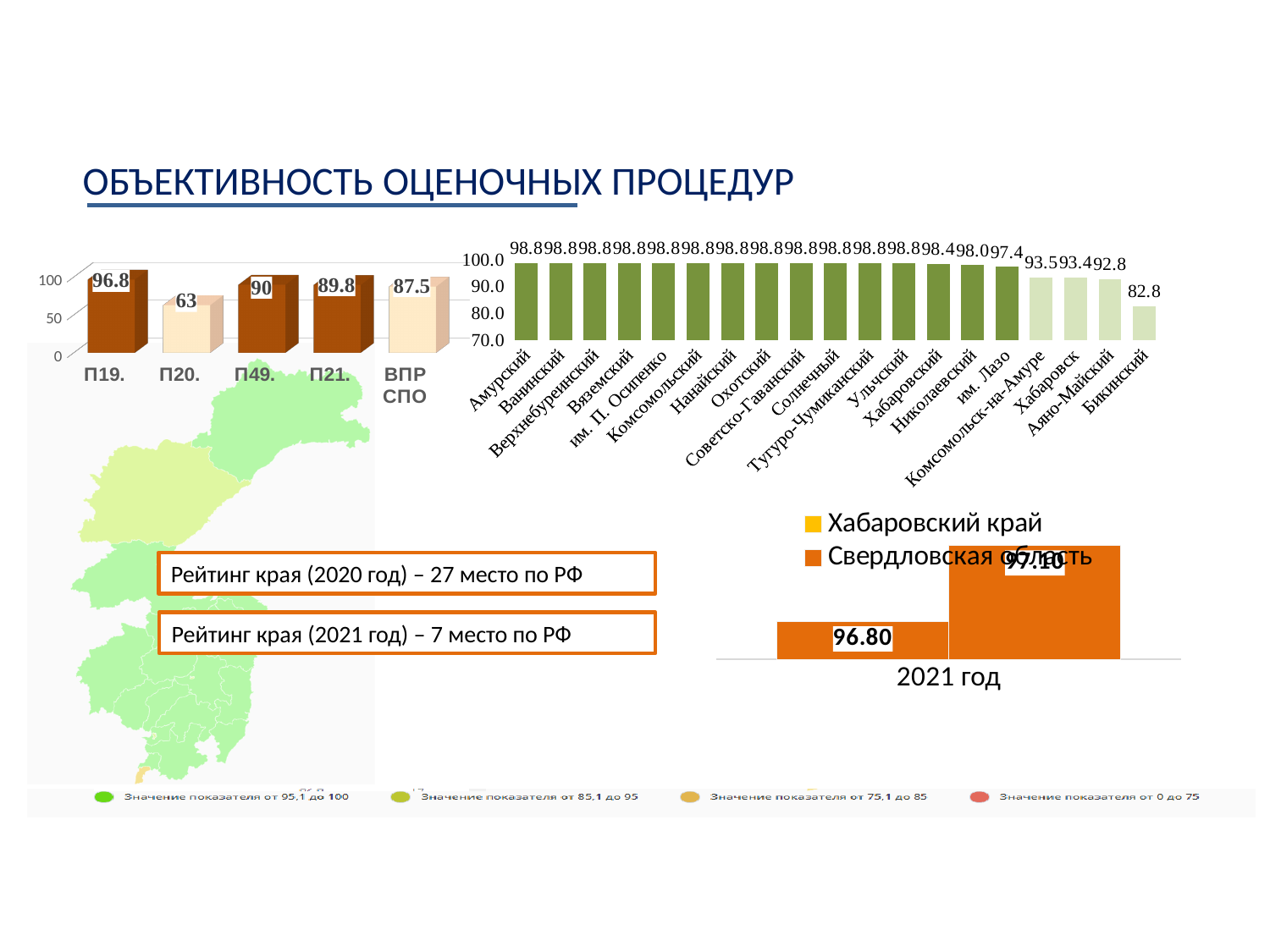
In the top-left bar chart, which category has the lowest value? П20. In the top-right bar chart of districts, what is the difference between the values for им. Лазо and Аяно-Майский? 4.6 In the top-left bar chart, what is the value for П19.? 96.8 In the top-right bar chart of districts, what is the value for Хабаровск? 93.4 In the top-right bar chart of districts, how many districts are shown? 19 In the bottom-right bar chart, how many series does the legend list? 2 In the top-right bar chart of districts, what is the value for Бикинский? 82.8 In the top-left bar chart, how many categories are shown? 5 In the top-right bar chart of districts, is the value for Комсомольск-на-Амуре larger or smaller than the value for Николаевский? smaller In the top-left bar chart, what is the value for ВПР СПО? 87.5 In the top-left bar chart, what is the difference between the values for П19. and П20.? 33.8 In the top-right bar chart of districts, which district has the lowest value? Бикинский